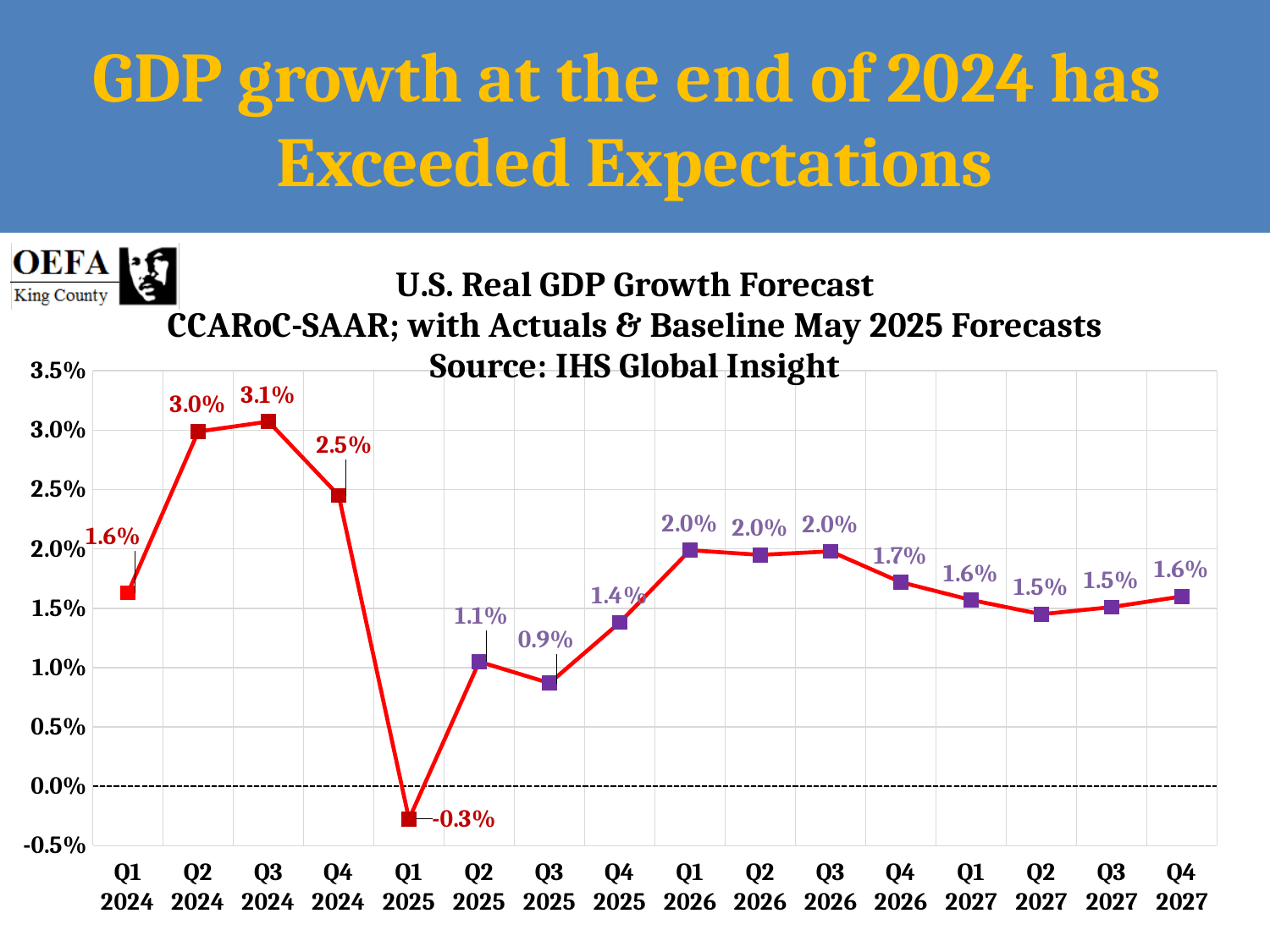
Which is larger, the value for Q2 2025 or the value for Q3 2025? Q2 2025 How many quarters are plotted on the chart? 16 What is the difference between the Q1 2026 value and the Q4 2025 value? 0.6% What is the GDP growth value for Q4 2026? 1.7% What is the source of the data cited in the chart title? IHS Global Insight What is the GDP growth value for Q1 2025? -0.3% What kind of chart is shown on the slide? Line chart Which quarter has the highest GDP growth value? Q3 2024 Do the values rise or fall from Q1 2024 to Q3 2024? Rise Which quarter has the lowest GDP growth value? Q1 2025 What is the difference between the Q3 2024 value and the Q4 2024 value? 0.6% What is the GDP growth value for Q3 2024? 3.1%